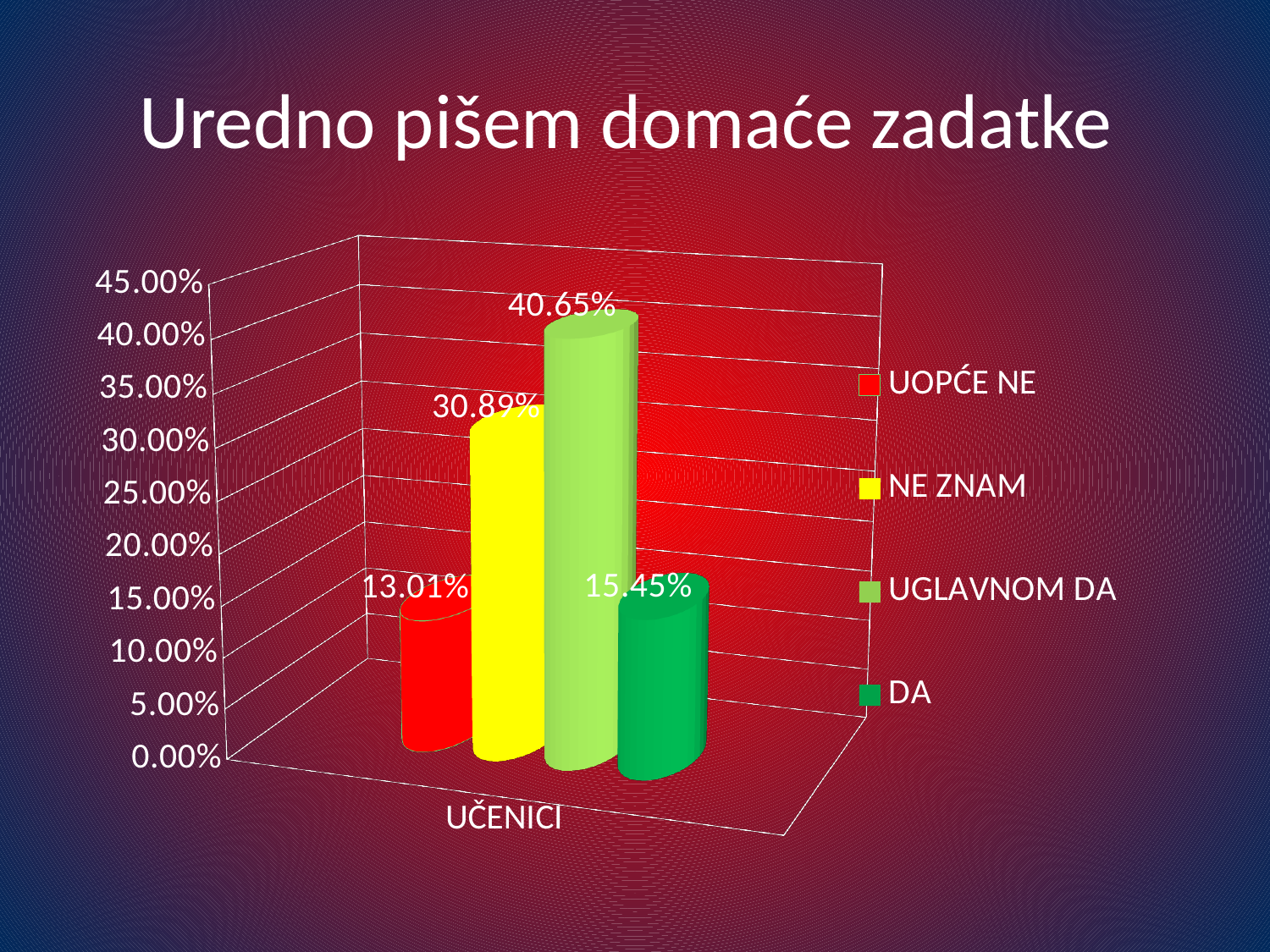
Is the value for NE ZNAM greater or less than 25.00%? greater What is the value for UOPĆE NE? 13.01% What is the title of the chart? Uredno pišem domaće zadatke What is the value for DA? 15.45% What is the value for NE ZNAM? 30.89% What kind of chart is shown on the slide? bar chart What is the value for UGLAVNOM DA? 40.65% Which series has the highest value? UGLAVNOM DA How many series does the legend list? 4 Which is larger, the value for DA or the value for UOPĆE NE? DA Which series has the lowest value? UOPĆE NE What is the difference between the values for UGLAVNOM DA and NE ZNAM? 9.76%